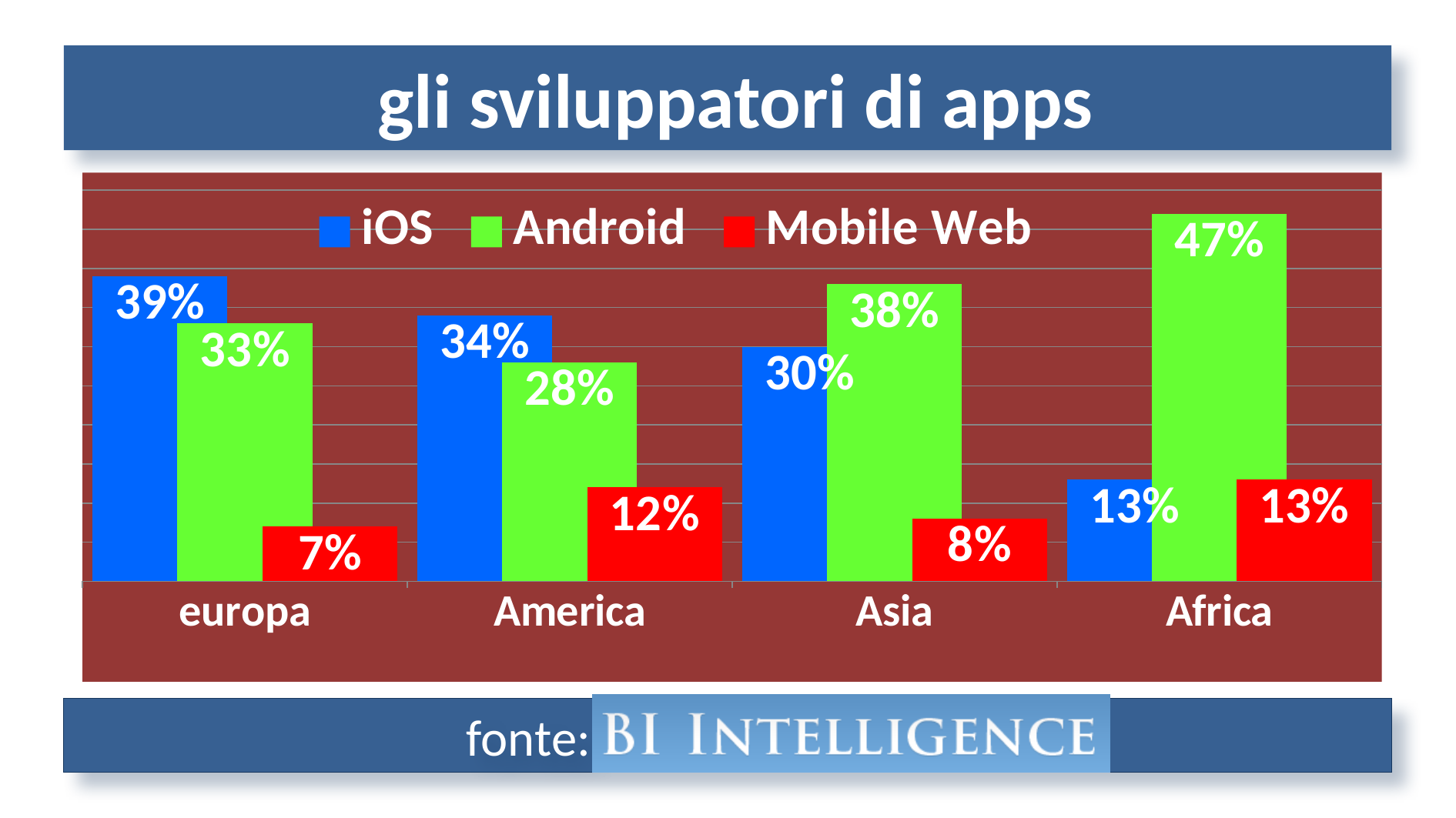
How many regions are shown on the x axis? 4 What kind of chart is shown on the slide? bar chart Which region has the highest Android value? Africa How many series does the legend list? 3 What is the Android value for Africa? 47% What is the iOS value for europa? 39% What is the difference between the iOS and Android values for Asia? 8% Which is larger for America, the iOS value or the Android value? iOS What is the Mobile Web value for America? 12% Which region has the lowest Mobile Web value? europa What is the title of the slide? gli sviluppatori di apps What is the Android value for Asia? 38%